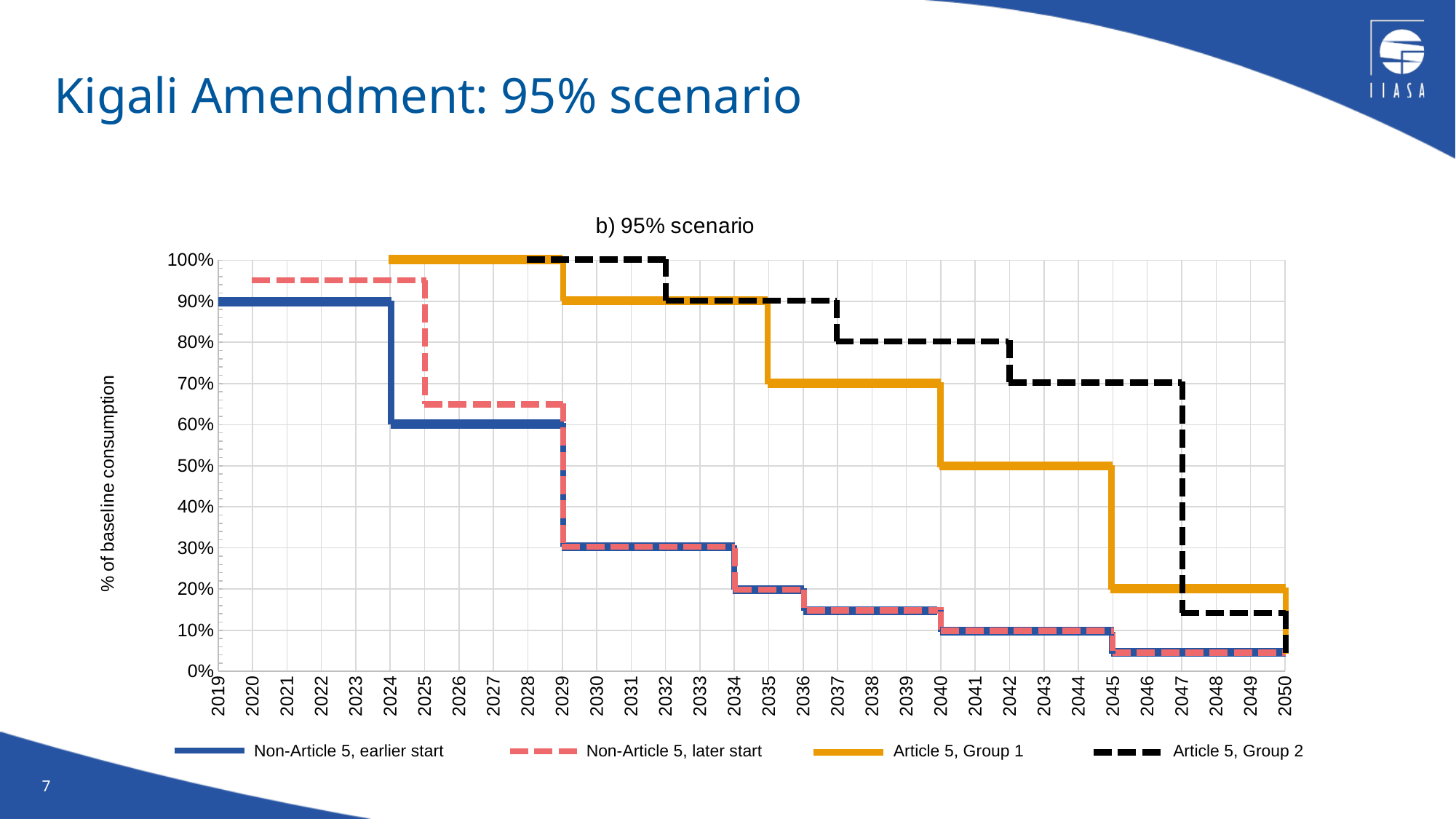
What kind of chart is shown on the slide? line chart What is the value for Article 5, Group 1 in 2037? 70% What is the title of the chart? b) 95% scenario What is the value for Article 5, Group 2 in 2039? 80% Is the value for Non-Article 5, later start in 2022 greater or less than 90%? greater In 2030, which is larger: Article 5, Group 1 or Non-Article 5, earlier start? Article 5, Group 1 How many series does the legend list? 4 Do the values for Article 5, Group 1 rise or fall from 2024 to 2050? fall What is the value for Non-Article 5, earlier start in 2021? 90% What is the difference between Article 5, Group 1 and Non-Article 5, earlier start in 2033? 60% Is the value for Non-Article 5, later start in 2027 greater or less than 60%? greater What is the value for Article 5, Group 1 in 2042? 50%